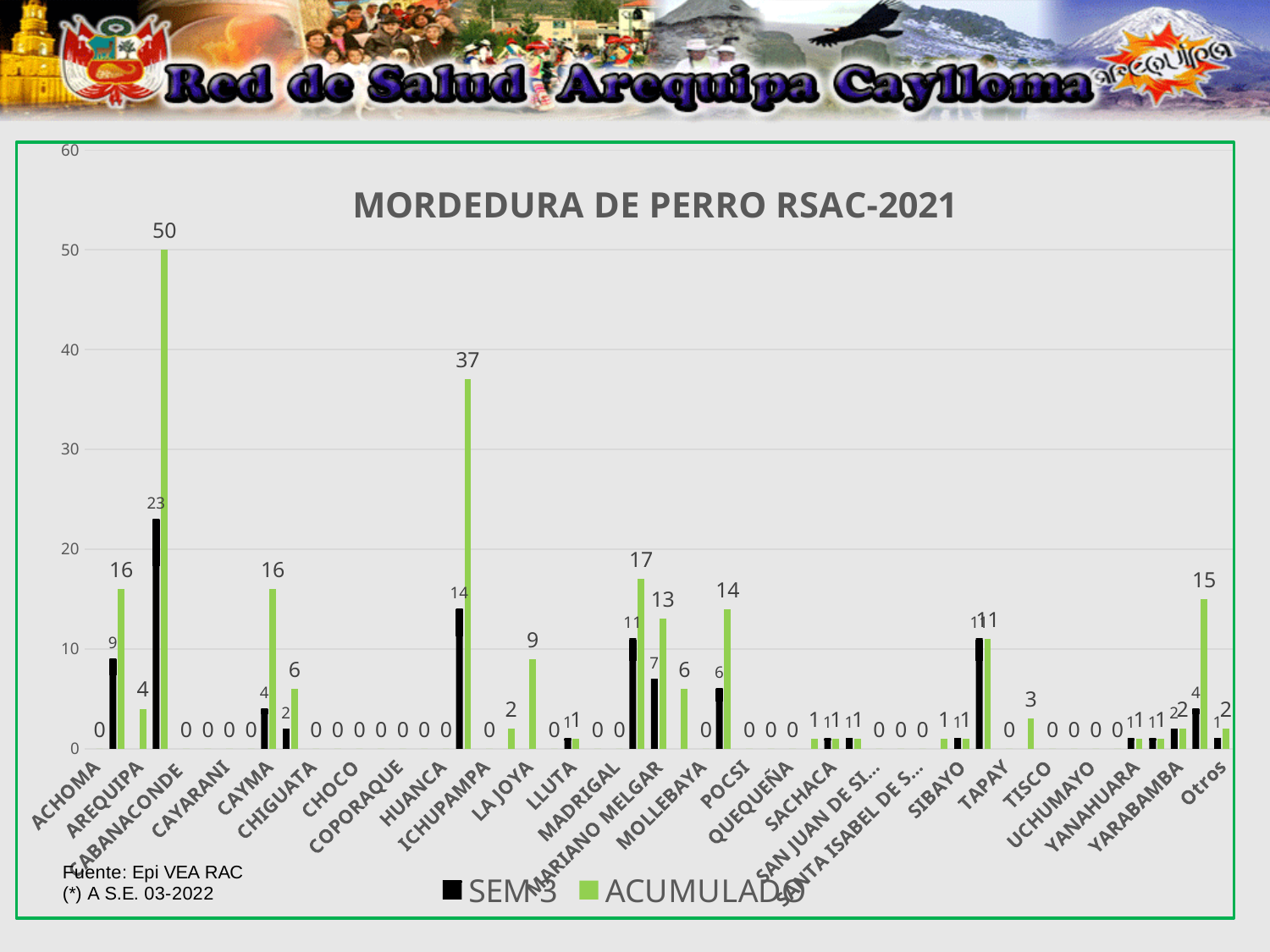
What is the difference between the two tallest ACUMULADO bars (50 and 37)? 13 Which series is drawn in green according to the legend? ACUMULADO Is the highest SEM 3 value greater or less than 30? less Is the highest ACUMULADO value greater or less than 40? greater What is the highest value shown for the SEM 3 series? 23 What is the highest value shown for the ACUMULADO series? 50 How many series does the chart legend list? 2 Which is larger: the tallest SEM 3 bar or the tallest ACUMULADO bar? the tallest ACUMULADO bar What is the difference between the tallest ACUMULADO bar (50) and the tallest SEM 3 bar (23)? 27 What is the second highest value shown for the ACUMULADO series? 37 What is the title of the chart? MORDEDURA DE PERRO RSAC-2021 What kind of chart is shown on the slide? bar chart